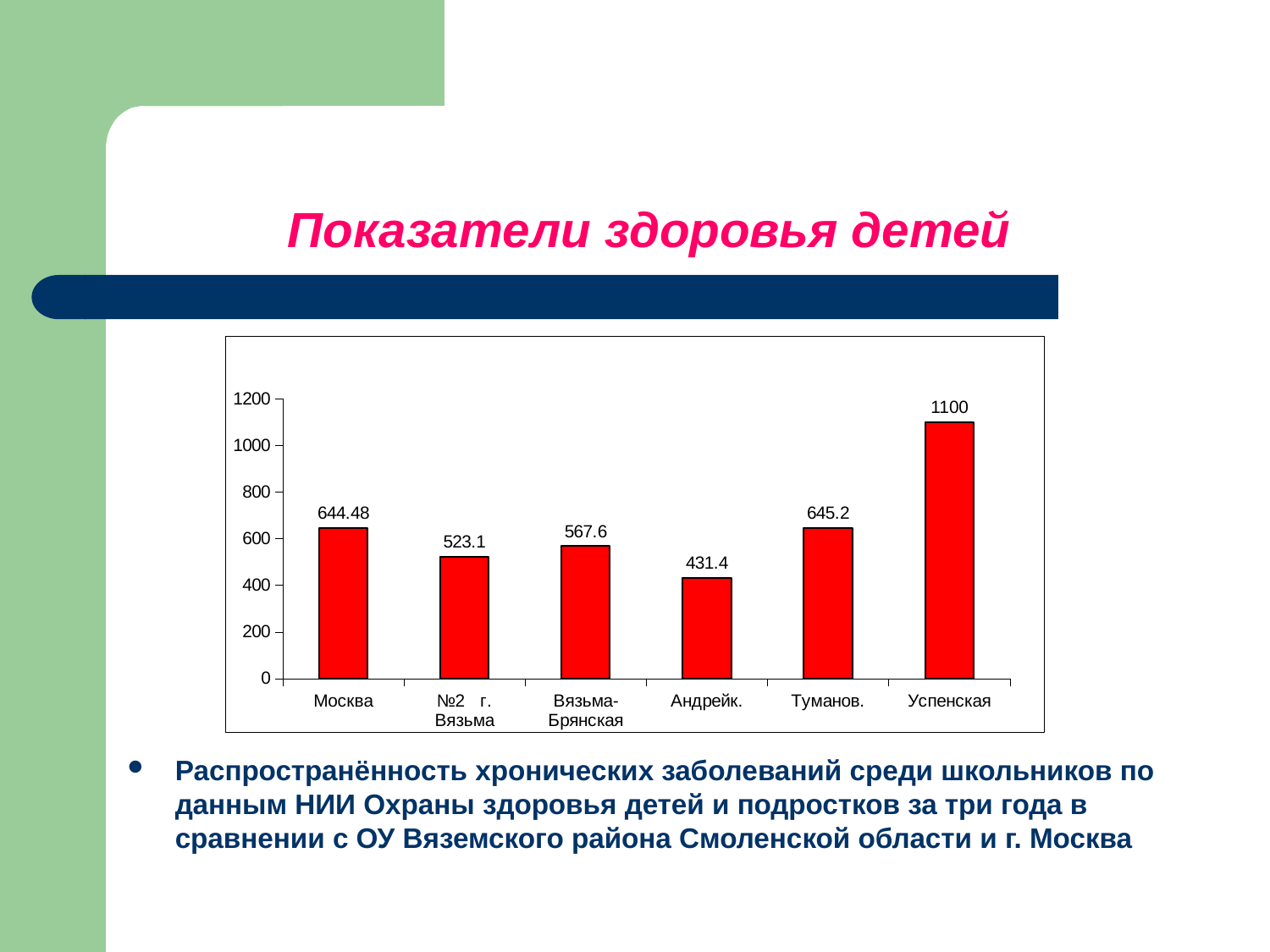
Is the value for Успенская greater or less than 1000? greater Which category has the lowest value? Андрейк. What is the value for Андрейк.? 431.4 What kind of chart is shown on the slide? bar chart What is the difference between the values for Успенская and Андрейк.? 668.6 Which category has the highest value? Успенская What is the value for Успенская? 1100 Which is larger, the value for Москва or the value for №2 г. Вязьма? Москва What is the difference between the values for Вязьма-Брянская and №2 г. Вязьма? 44.5 How many categories are shown on the x axis? 6 What is the value for Москва? 644.48 What is the value for Вязьма-Брянская? 567.6